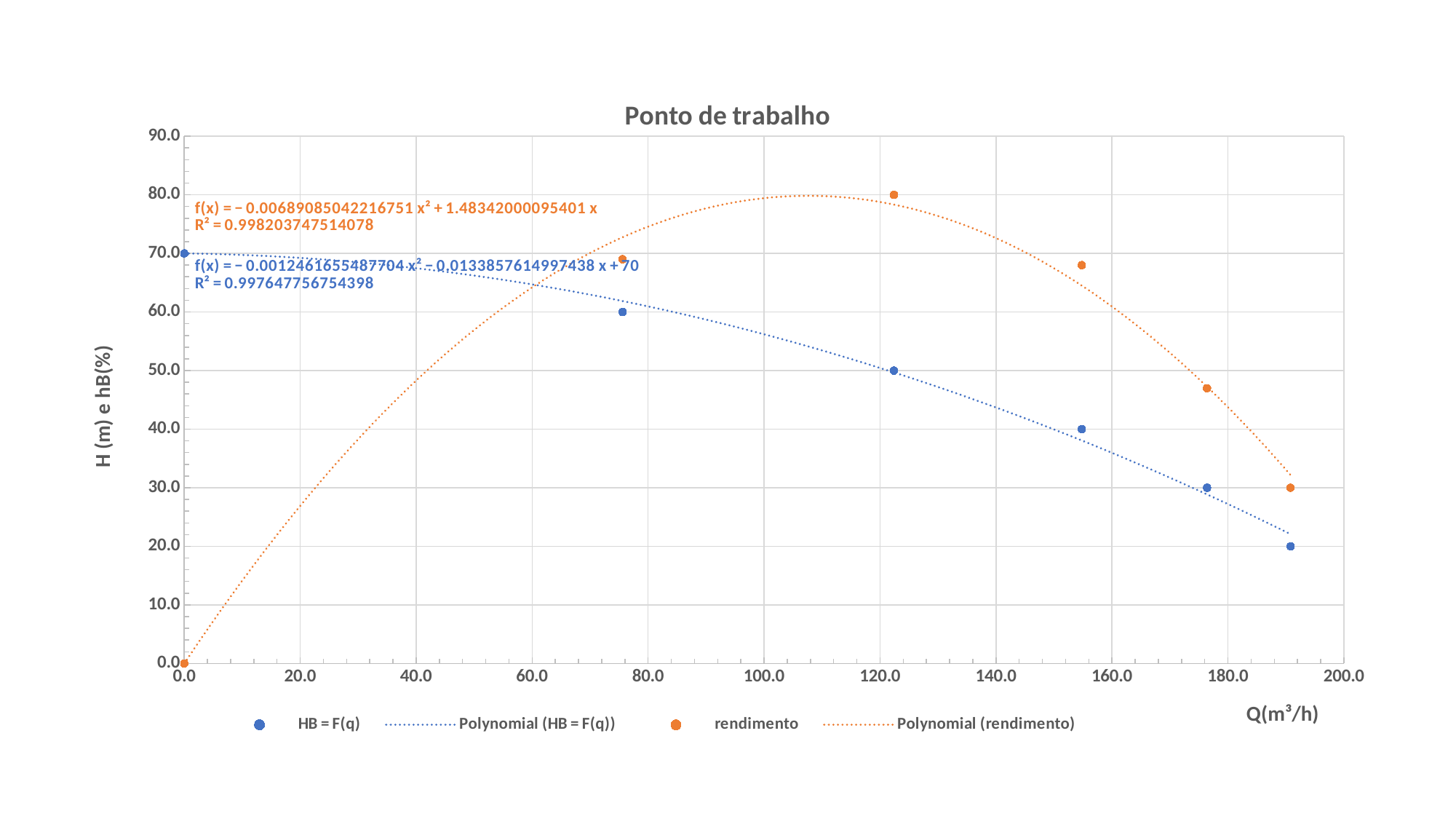
Is the rightmost HB = F(q) point greater or less than 30.0? less What is the title of the chart? Ponto de trabalho Is the highest rendimento point greater or less than 70.0? greater How many entries does the legend list? 4 Which series reaches the highest value on the chart? rendimento What is the rendimento value at Q = 0.0? 0.0 Around Q = 120, which series has the higher value, HB = F(q) or rendimento? rendimento Do the HB = F(q) values rise or fall as Q increases? fall What is the HB = F(q) value at Q = 0.0? 70.0 How many data points are plotted for the HB = F(q) series? 6 What R² value is shown for the rendimento polynomial fit? 0.998203747514078 What kind of chart is shown on the slide? scatter chart